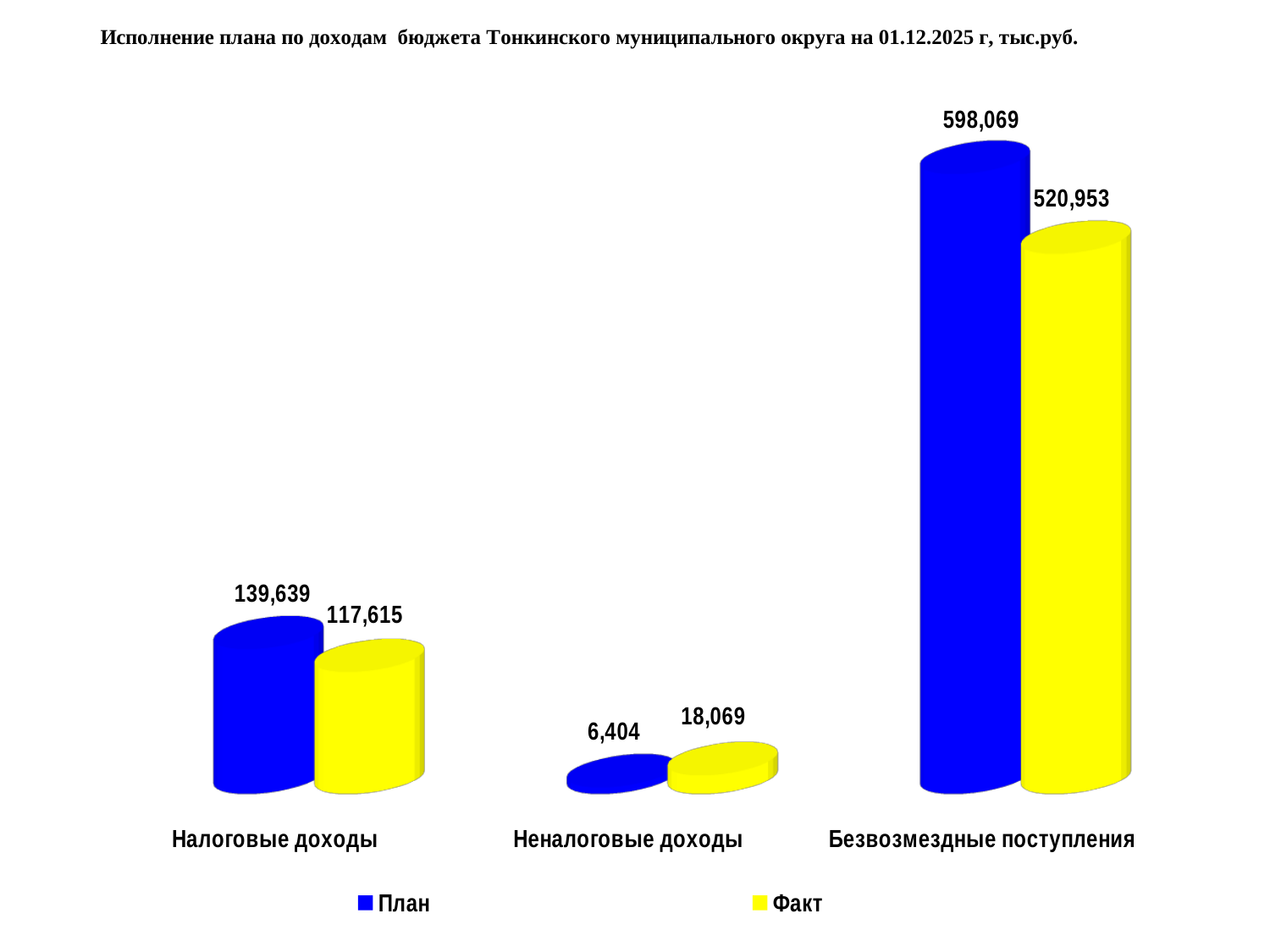
Which colour represents the Факт series? Yellow What is the Факт value for Неналоговые доходы? 18,069 Which category has the lowest Факт value? Неналоговые доходы What is the difference between the План and Факт values for Налоговые доходы? 22,024 For Неналоговые доходы, which is larger: План or Факт? Факт What is the difference between the План and Факт values for Безвозмездные поступления? 77,116 How many categories are shown on the x axis? 3 What kind of chart is shown on the slide? Bar chart Which category has the highest План value? Безвозмездные поступления What is the План value for Налоговые доходы? 139,639 How many series does the legend list? 2 What is the Факт value for Безвозмездные поступления? 520,953